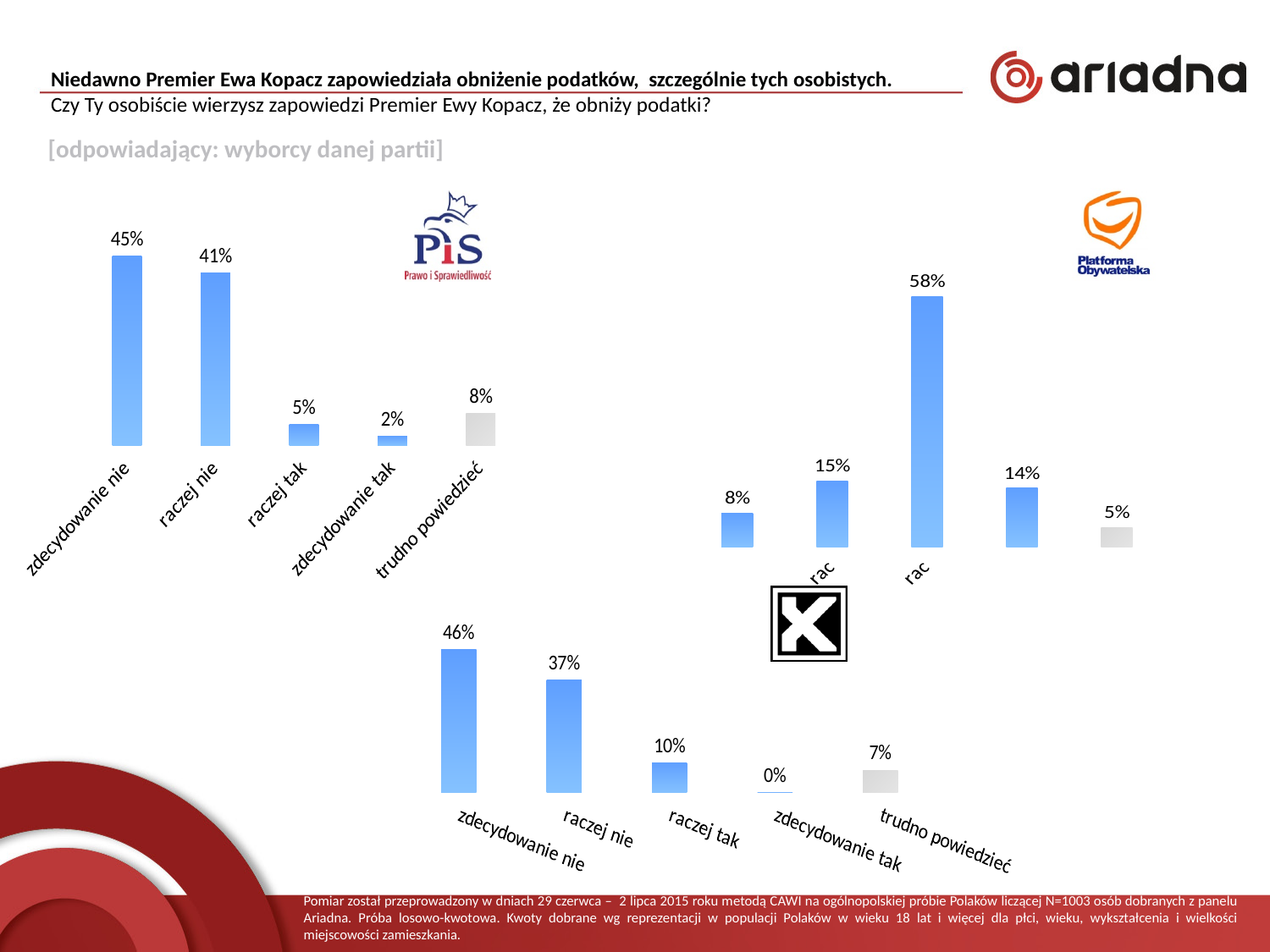
In the Platforma Obywatelska chart (top right), what is the highest value shown? 58% In the PiS chart (top left), what is the difference between "zdecydowanie nie" and "raczej nie"? 4 percentage points In the PiS chart (top left), which category has the lowest value? zdecydowanie tak What type of chart is used for the PiS data (top left)? Bar chart In the PiS chart (top left), what is the value for "trudno powiedzieć"? 8% In the PiS chart (top left), what is the value for "zdecydowanie nie"? 45% In the Platforma Obywatelska chart (top right), how many bars are plotted? 5 In the bottom chart, what is the value for "zdecydowanie tak"? 0% In the bottom chart, what is the value for "zdecydowanie nie"? 46% In the bottom chart, which is larger: "raczej tak" or "trudno powiedzieć"? raczej tak In the PiS chart (top left), what is the value for "raczej nie"? 41% In the bottom chart, what is the difference between "zdecydowanie nie" and "raczej nie"? 9 percentage points